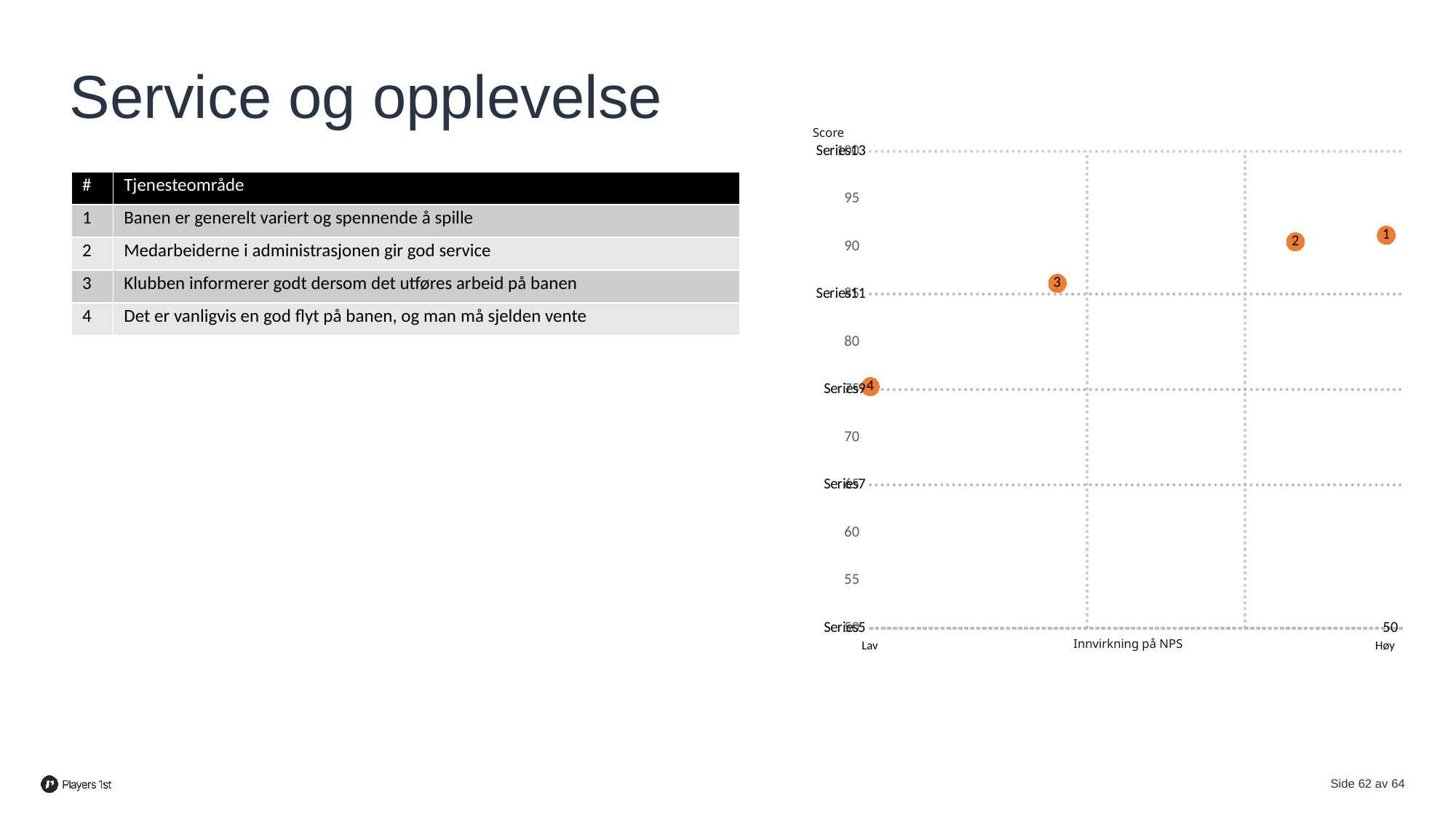
Which numbered point has the lowest score in the chart? 4 Which has the higher score, point 3 or point 4? 3 Which numbered point is furthest to the right (highest Innvirkning på NPS) in the chart? 1 Is the score for point 3 greater or less than 90? less Is the score for point 4 greater or less than 80? less Which numbered point is furthest to the left (lowest Innvirkning på NPS) in the chart? 4 What is the title of the vertical axis of the chart? Score How many data points are plotted in the chart? 4 What kind of chart is shown on the slide? scatter chart Is the score for point 3 greater or less than 80? greater What is the title of the horizontal axis of the chart? Innvirkning på NPS